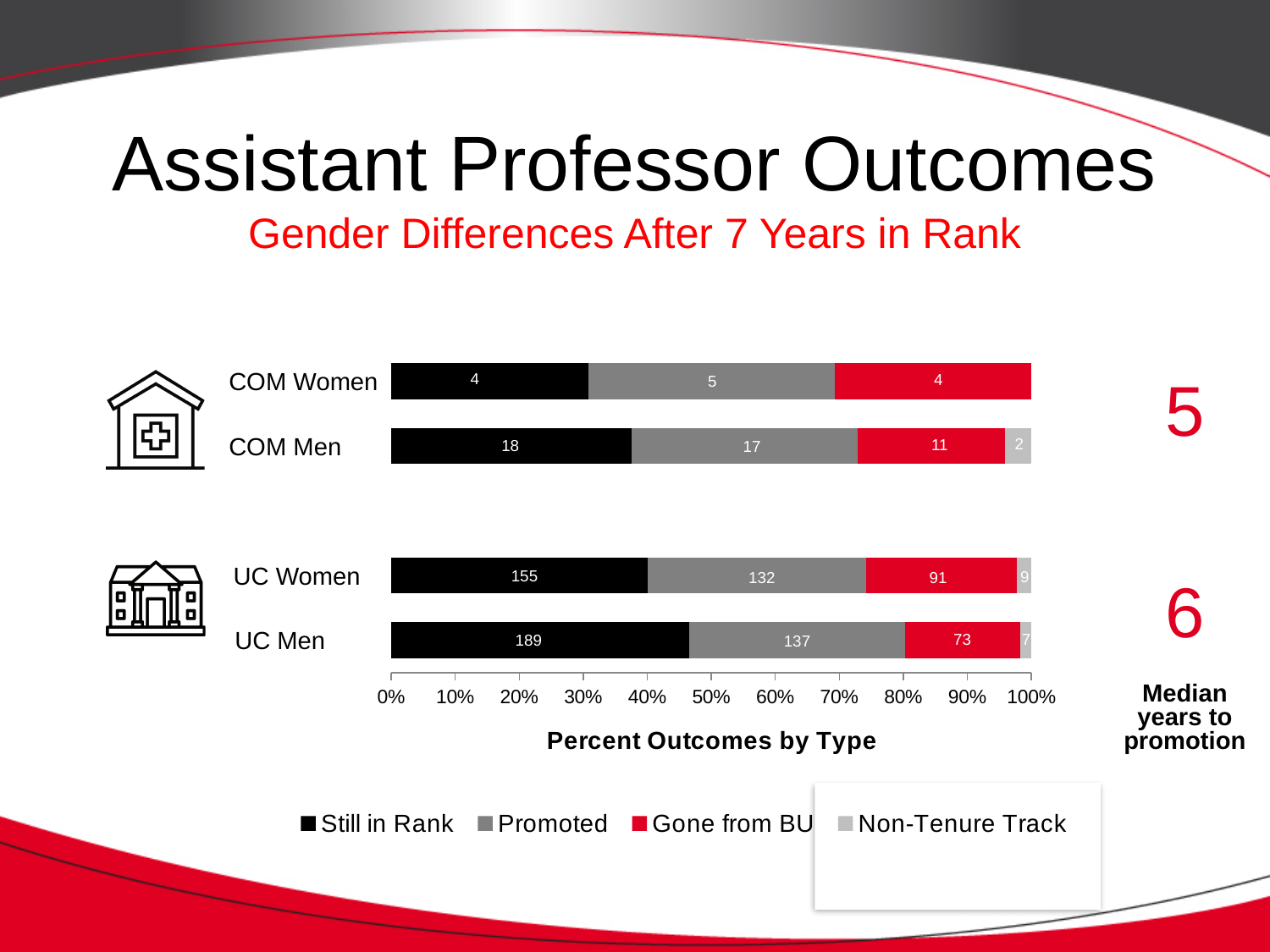
What is the Gone from BU value for COM Men? 11 What is the Promoted value for UC Women? 132 What is the difference between the Gone from BU values for UC Women and UC Men? 18 What is the x-axis title of the chart? Percent Outcomes by Type What is the total of all segments in the COM Men bar? 48 How many categories (bars) are plotted in the chart? 4 What is the Non-Tenure Track value for UC Women? 9 How many series does the chart legend list? 4 Which is larger, the Promoted value for COM Men or the Promoted value for COM Women? COM Men What is the Still in Rank value for UC Men? 189 What kind of chart is shown on the slide? Stacked bar chart Which category has the highest Still in Rank value? UC Men